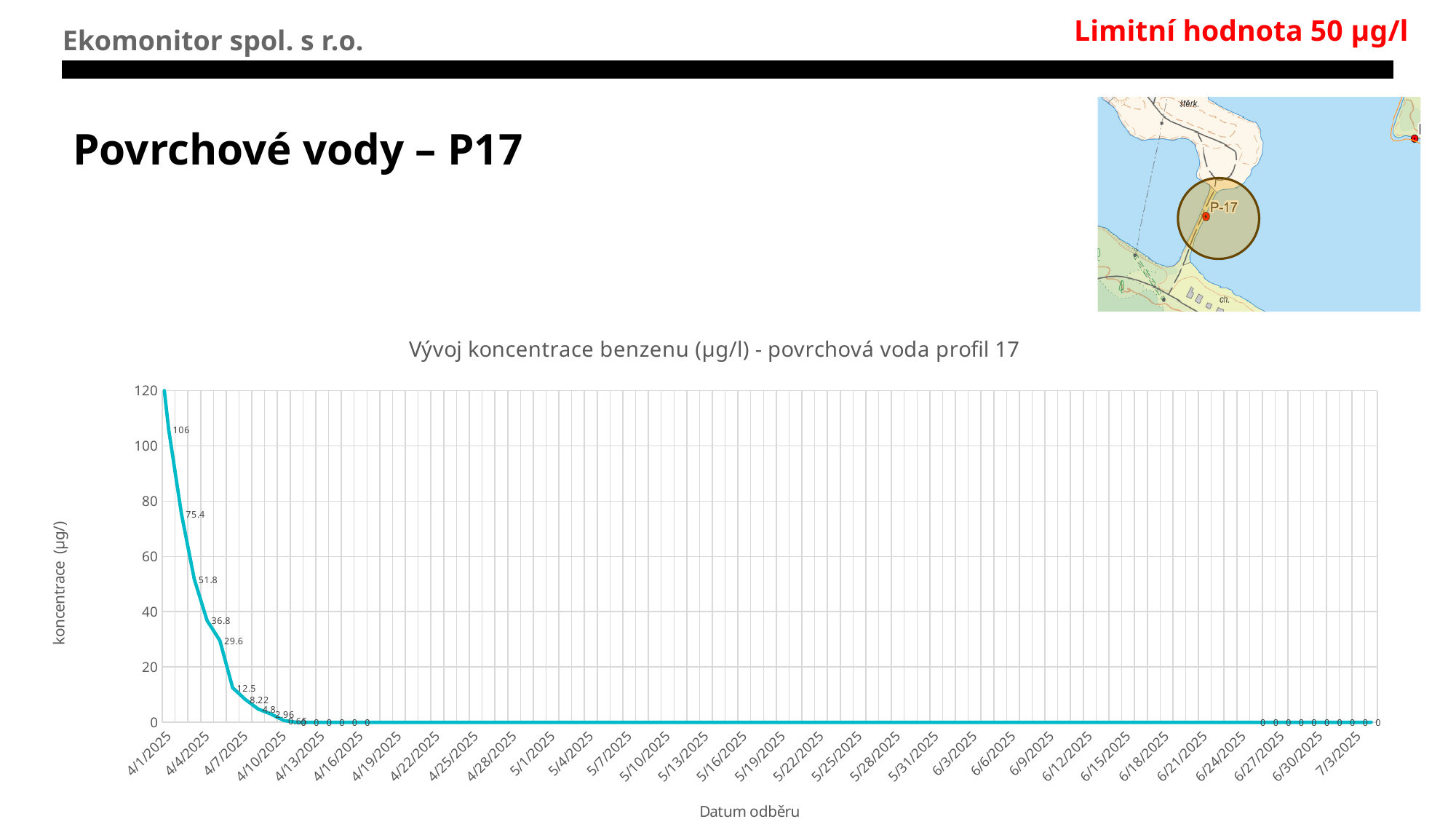
What is the value for 6/27/2025? 0 Is the value for 4/13/2025 greater or less than 20? less What is the title of the chart? Vývoj koncentrace benzenu (µg/l) - povrchová voda profil 17 Is the value for 4/4/2025 greater or less than 80? less Is the value for 4/1/2025 greater or less than 100? greater What kind of chart is shown on the slide? line chart Do the benzene concentration values rise or fall along the x axis from 4/1/2025 onward? fall What is the value for 7/3/2025? 0 What limit value is stated in red at the top of the slide? 50 µg/l Which is larger, the value for 4/1/2025 or the value for 4/7/2025? 4/1/2025